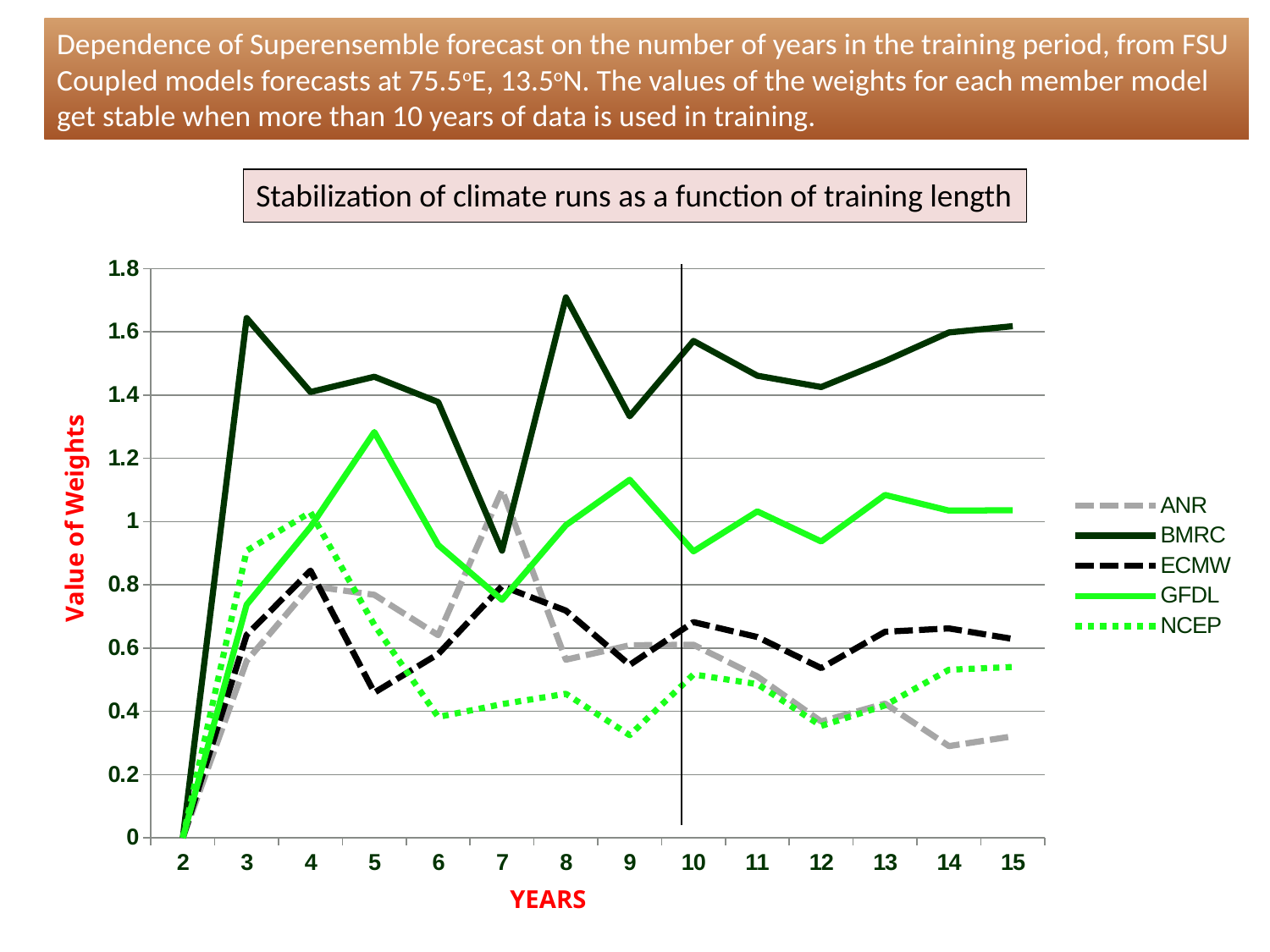
What is the title of the chart? Stabilization of climate runs as a function of training length How many series does the legend list? 5 Is the value for ANR at year 14 greater or less than 0.4? less How many year values are shown along the x axis? 14 Which series has the highest weight at year 15? BMRC Which series has the lowest weight at year 15? ANR What is the value of the BMRC weight at year 2? 0 At year 7, which series has the larger weight, ANR or GFDL? ANR Does the BMRC weight rise or fall from year 12 to year 15? rise What kind of chart is shown on the slide? line chart Is the value for GFDL at year 5 greater or less than 1.2? greater Is the value for BMRC at year 8 greater or less than 1.6? greater